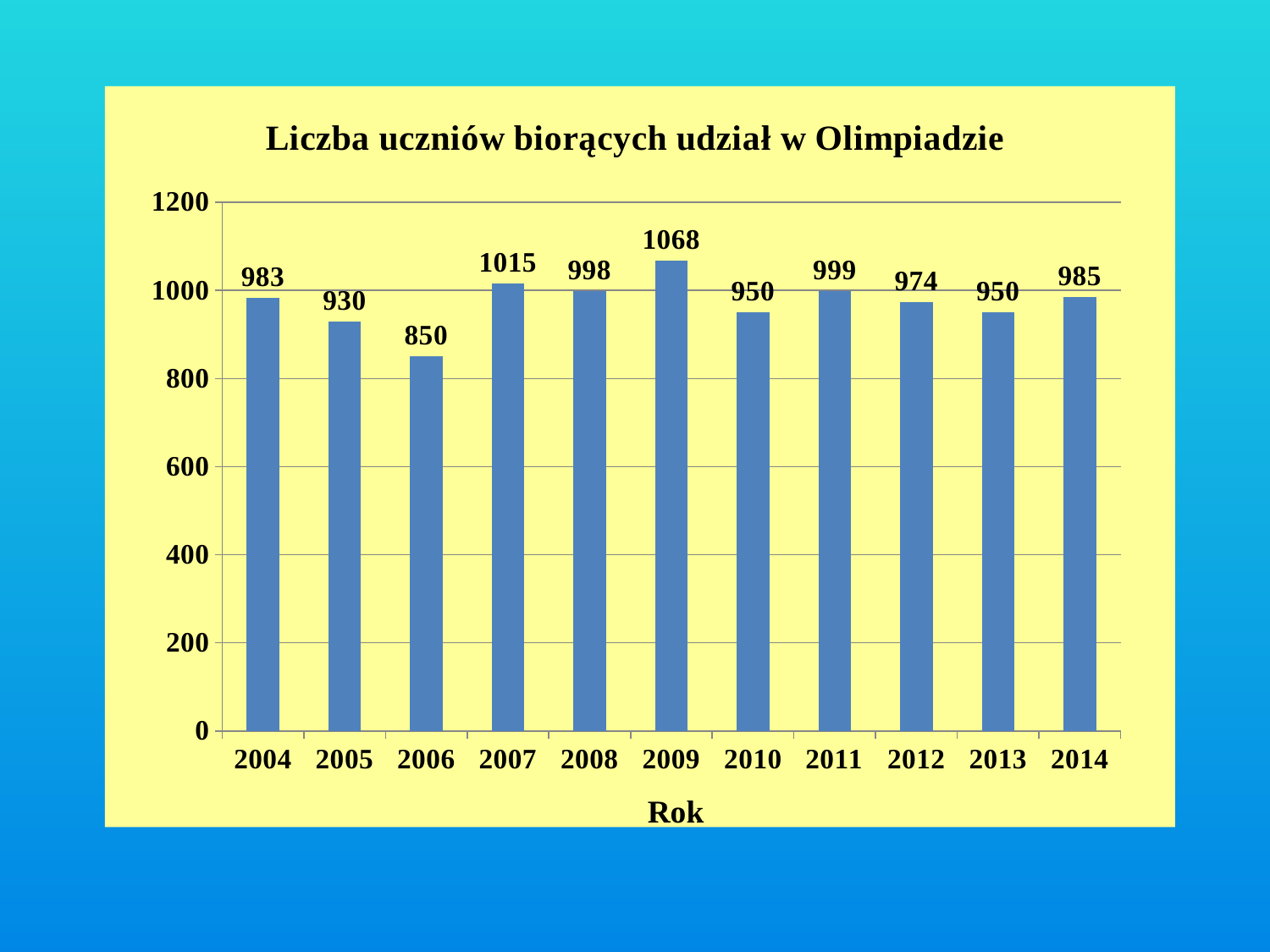
What is the difference between the values for 2009 and 2006? 218 Which year has the highest value? 2009 How many years are shown on the x axis? 11 What is the value for 2006? 850 Is the value for 2007 greater or less than 1000? greater What is the value for 2009? 1068 What is the title of the chart? Liczba uczniów biorących udział w Olimpiadzie What kind of chart is shown on the slide? bar chart Which year has the lowest value? 2006 What is the value for 2012? 974 What is the difference between the values for 2007 and 2005? 85 Which is larger, the value for 2004 or the value for 2005? 2004